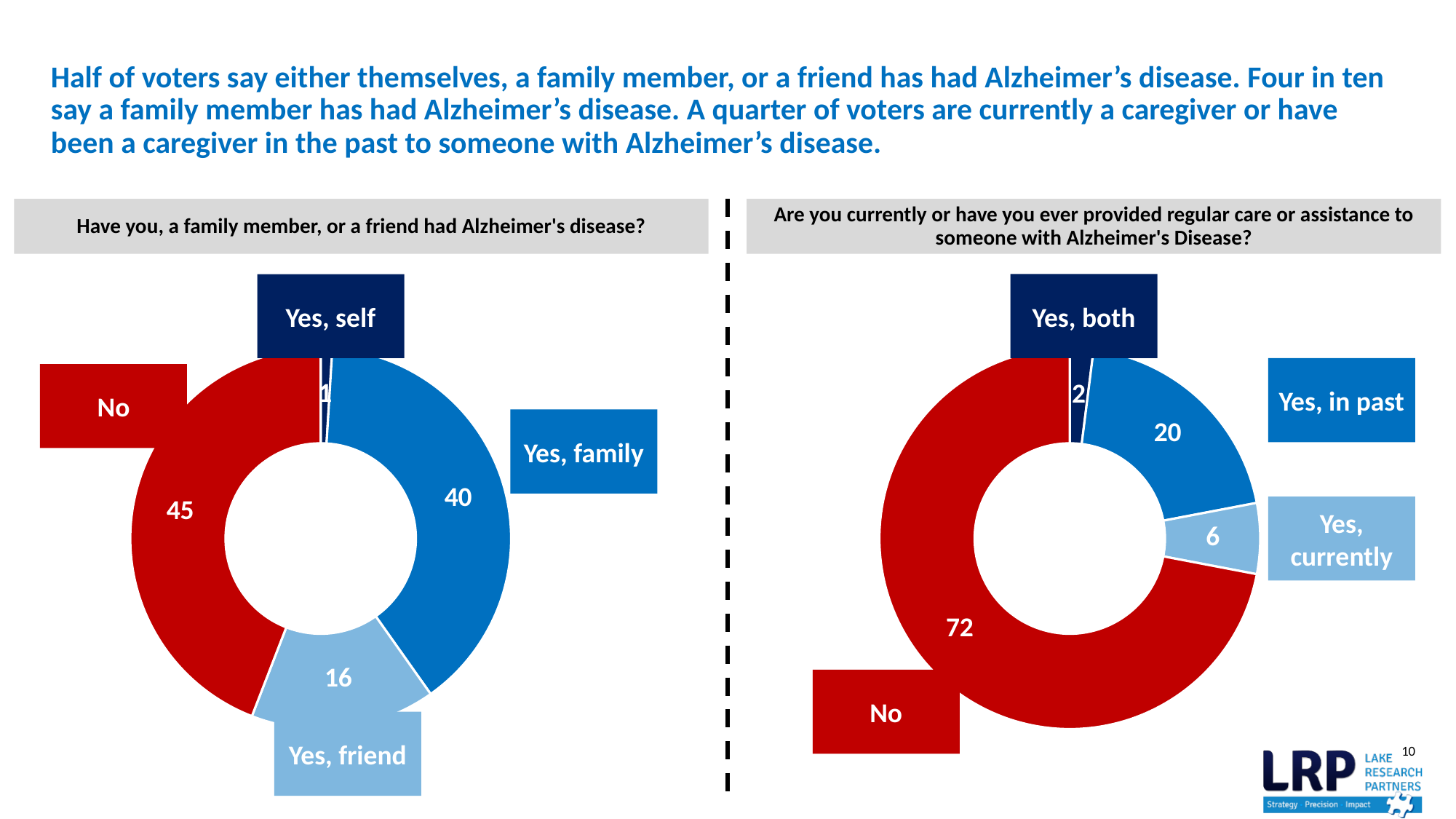
In the left chart (Have you, a family member, or a friend had Alzheimer's disease?), what value is shown for "No"? 45 In the right chart (Are you currently or have you ever provided regular care or assistance to someone with Alzheimer's Disease?), which is larger: "Yes, in past" or "Yes, currently"? Yes, in past In the right chart (Are you currently or have you ever provided regular care or assistance to someone with Alzheimer's Disease?), how many categories are shown? 4 In the left chart (Have you, a family member, or a friend had Alzheimer's disease?), what value is shown for "Yes, friend"? 16 In the left chart (Have you, a family member, or a friend had Alzheimer's disease?), which category has the largest slice? No In the left chart (Have you, a family member, or a friend had Alzheimer's disease?), what is the difference between the "No" value and the "Yes, family" value? 5 In the right chart (Are you currently or have you ever provided regular care or assistance to someone with Alzheimer's Disease?), which category has the smallest slice? Yes, both In the left chart (Have you, a family member, or a friend had Alzheimer's disease?), what value is shown for "Yes, family"? 40 In the right chart (Are you currently or have you ever provided regular care or assistance to someone with Alzheimer's Disease?), what value is shown for "Yes, in past"? 20 What type of chart is used on the left side of the slide? Donut (pie) chart In the right chart (Are you currently or have you ever provided regular care or assistance to someone with Alzheimer's Disease?), what value is shown for "No"? 72 In the right chart (Are you currently or have you ever provided regular care or assistance to someone with Alzheimer's Disease?), what value is shown for "Yes, currently"? 6